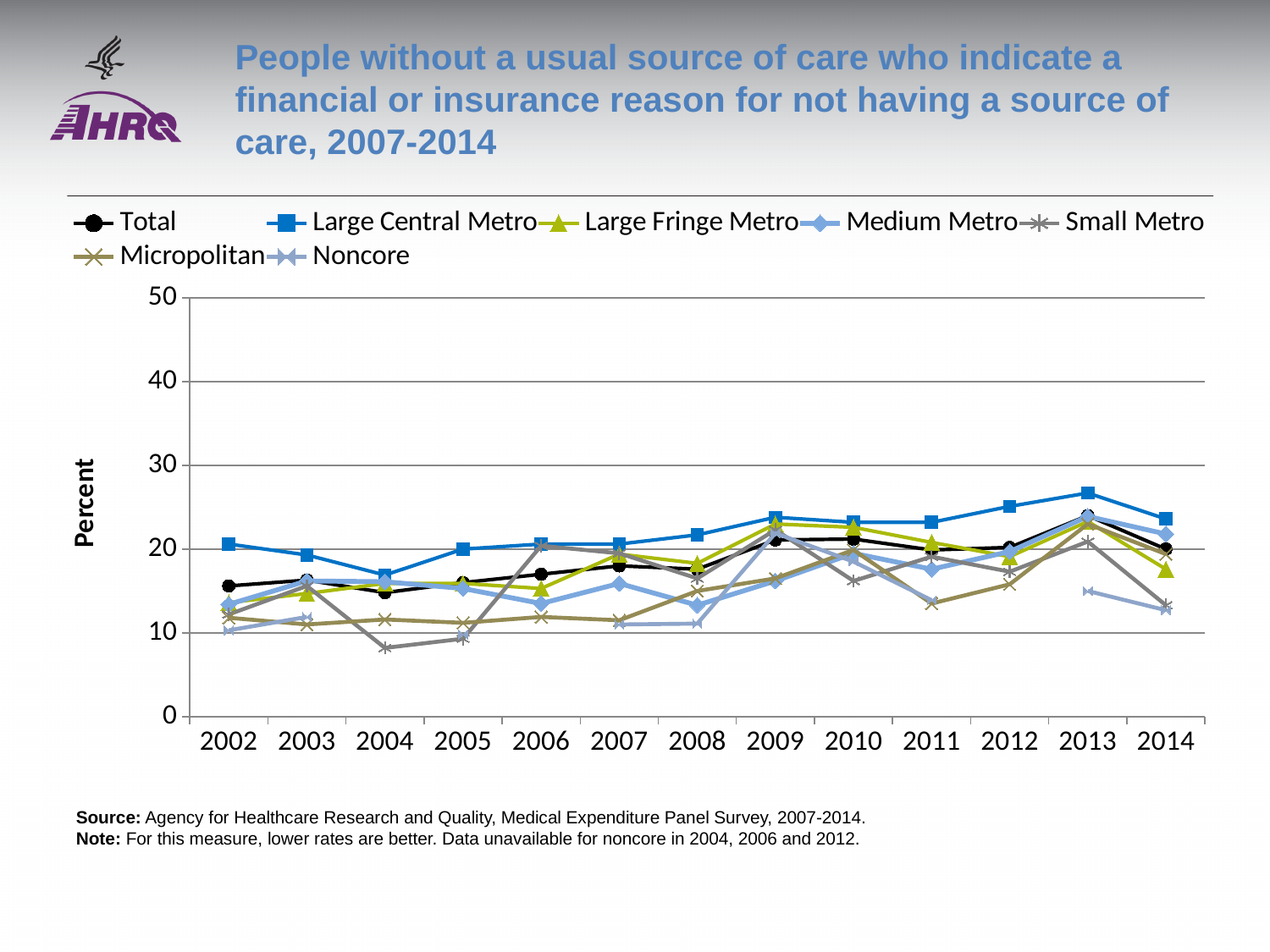
Does the Total line rise or fall overall from 2002 to 2014? rise What is the label on the y axis? Percent Is the value for Small Metro in 2004 greater or less than 10? less In 2002, which is larger: Large Central Metro or Total? Large Central Metro Is the value for Total in 2002 greater or less than 20? less Which series has the lowest value in 2004? Small Metro How many years are shown along the x axis? 13 How many series does the legend list? 7 Is the value for Large Central Metro in 2013 greater or less than 25? greater Which series has the highest value in 2013? Large Central Metro What kind of chart is shown on the slide? line chart